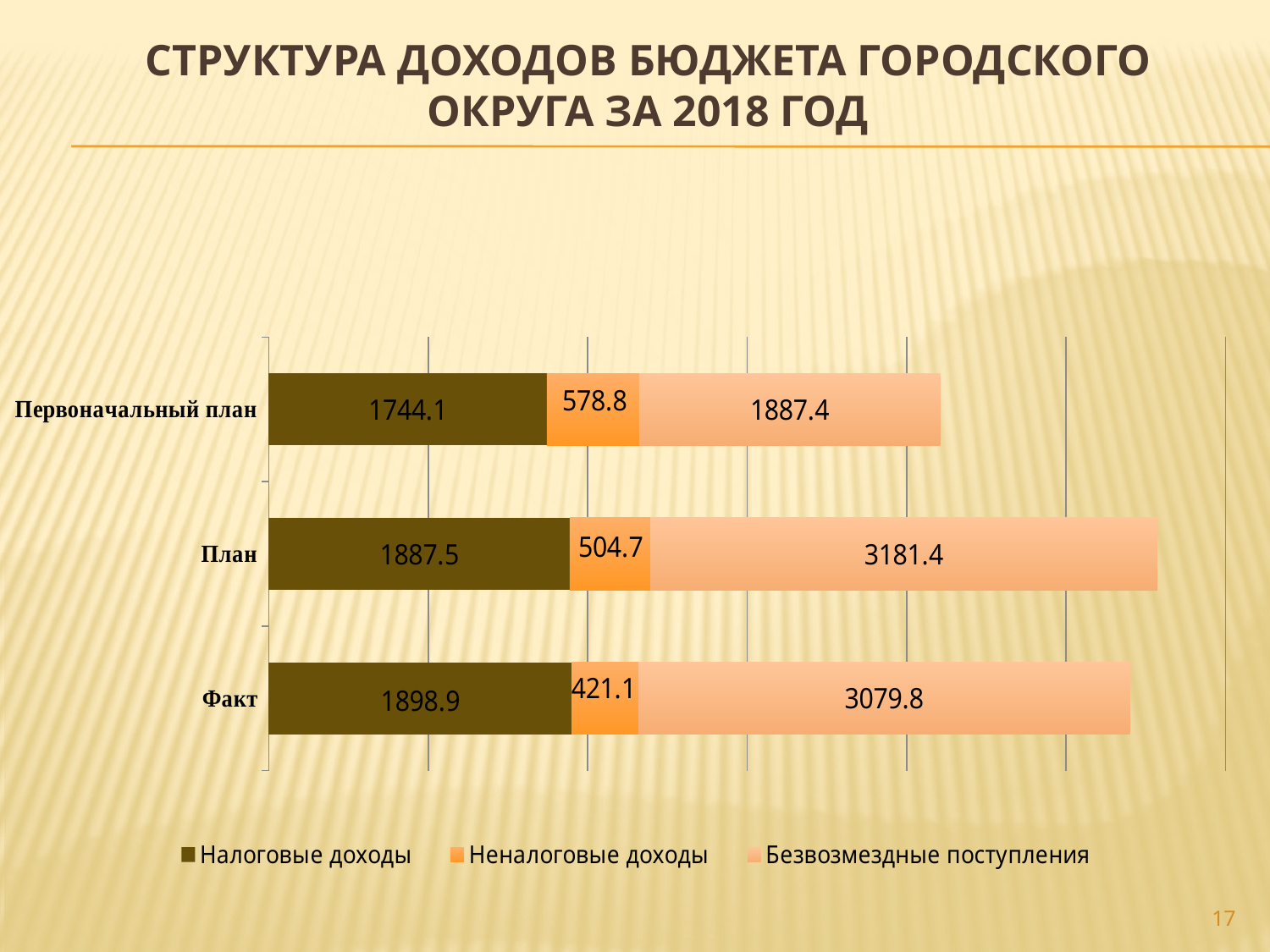
What is the total of the stacked bar for Факт? 5399.8 What kind of chart is shown on the slide? Stacked bar chart Which category has the highest value for Безвозмездные поступления? План What is the value of Неналоговые доходы for Первоначальный план? 578.8 How many categories are shown on the chart? 3 What is the total of the stacked bar for Первоначальный план? 4210.3 Which is larger: Налоговые доходы for План or Налоговые доходы for Первоначальный план? План What is the value of Безвозмездные поступления for План? 3181.4 How many series does the legend list? 3 What is the difference between Безвозмездные поступления for План and for Факт? 101.6 Which category has the lowest value for Неналоговые доходы? Факт What is the value of Налоговые доходы for Факт? 1898.9